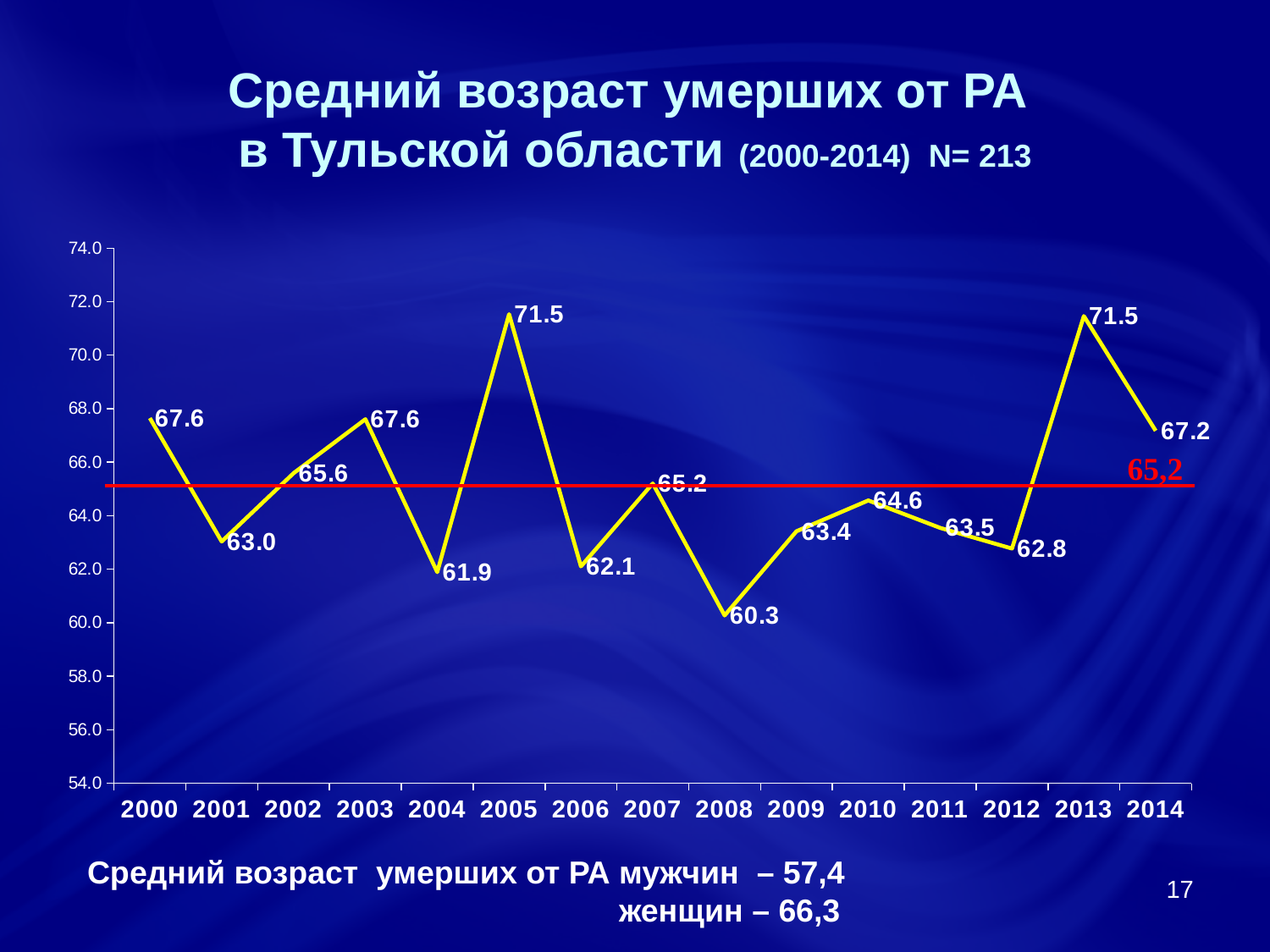
What is the difference between the values for 2013 and 2012? 8.7 What kind of chart is shown on the slide? line chart Which year has the lowest value on the chart? 2008 What value is plotted for 2008? 60.3 What value is shown for 2000? 67.6 What is the highest value plotted on the chart? 71.5 What is the average age of death shown for 2005? 71.5 How many years are plotted on the x axis? 15 Which year has the larger value, 2004 or 2006? 2006 What is the value for 2014? 67.2 Does the value rise or fall from 2013 to 2014? fall What value is marked by the red horizontal line on the chart? 65,2